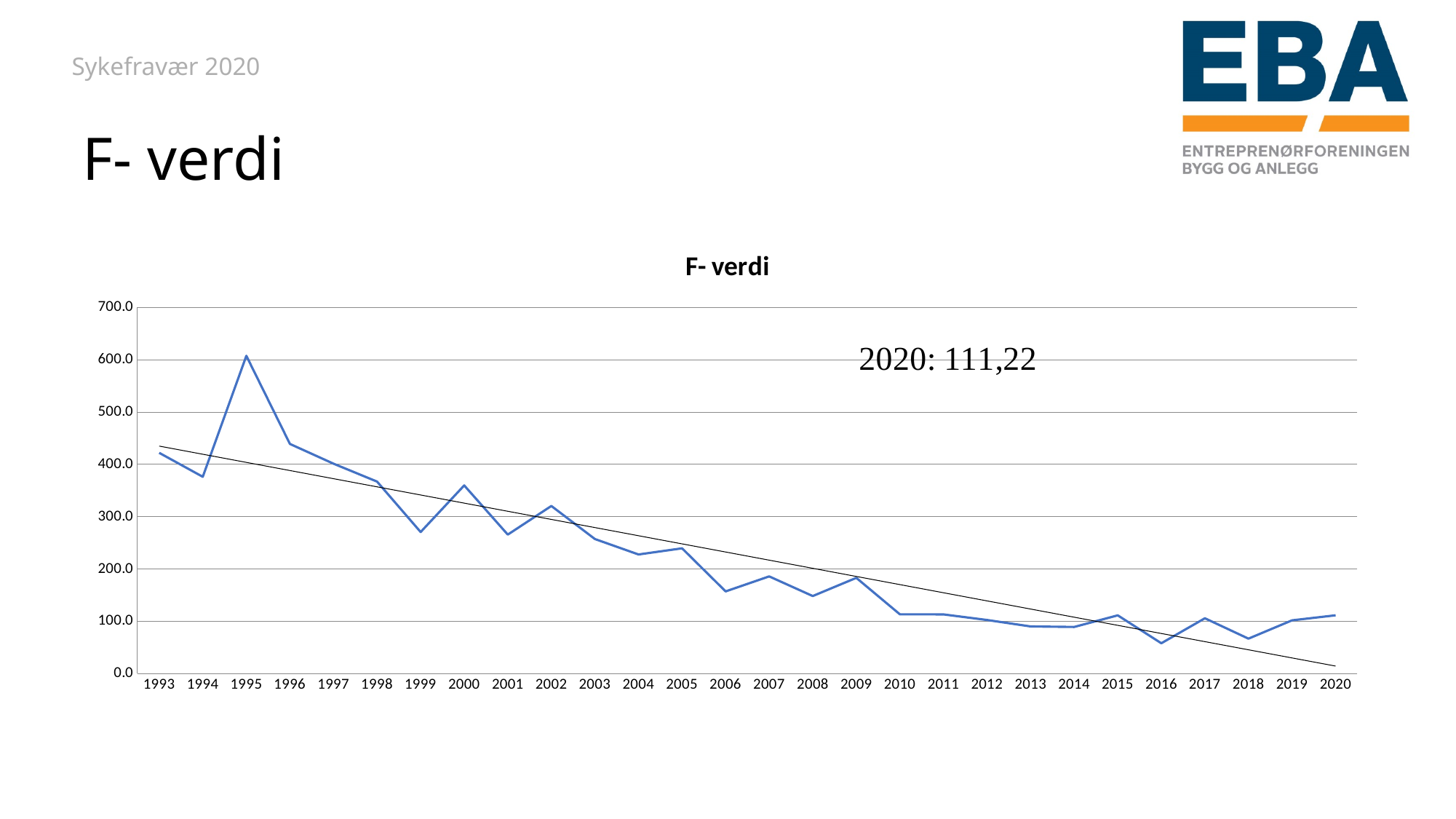
Is the value for 2000 greater or less than 300? greater Is the value for 1995 greater or less than 500? greater Is the value for 2010 greater or less than 200? less Which year has the larger F- verdi value, 2009 or 2010? 2009 What kind of chart is shown on the slide? line chart How many years are plotted along the x axis of the chart? 28 Which year has the highest F- verdi value? 1995 What is the F- verdi value for 2020 as printed on the chart? 111,22 Which year has the larger F- verdi value, 1995 or 1996? 1995 What is the title of the chart? F- verdi Do the F- verdi values generally rise or fall from 1993 to 2020? fall